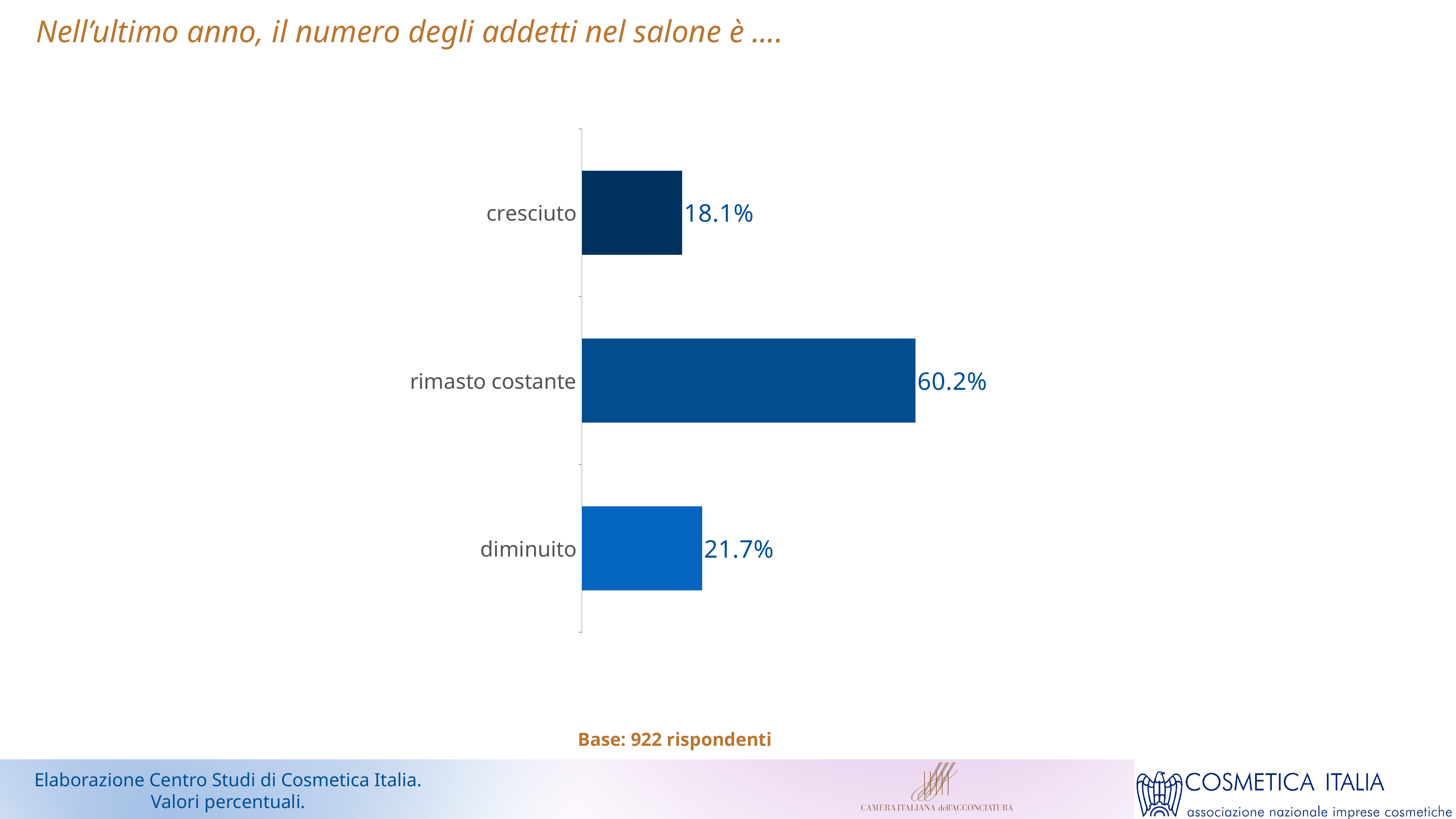
Which category has the lowest value? cresciuto What is the difference between the values for "diminuito" and "cresciuto"? 3.6% What is the value for "rimasto costante"? 60.2% What is the value for "diminuito"? 21.7% What is the title of the slide? Nell'ultimo anno, il numero degli addetti nel salone è …. What is the difference between the values for "rimasto costante" and "diminuito"? 38.5% Which is larger, the value for "diminuito" or the value for "cresciuto"? diminuito What kind of chart is shown on the slide? bar chart What is the base (number of respondents) stated below the chart? 922 rispondenti How many categories are shown in the chart? 3 Which category has the highest value? rimasto costante What is the value for "cresciuto"? 18.1%